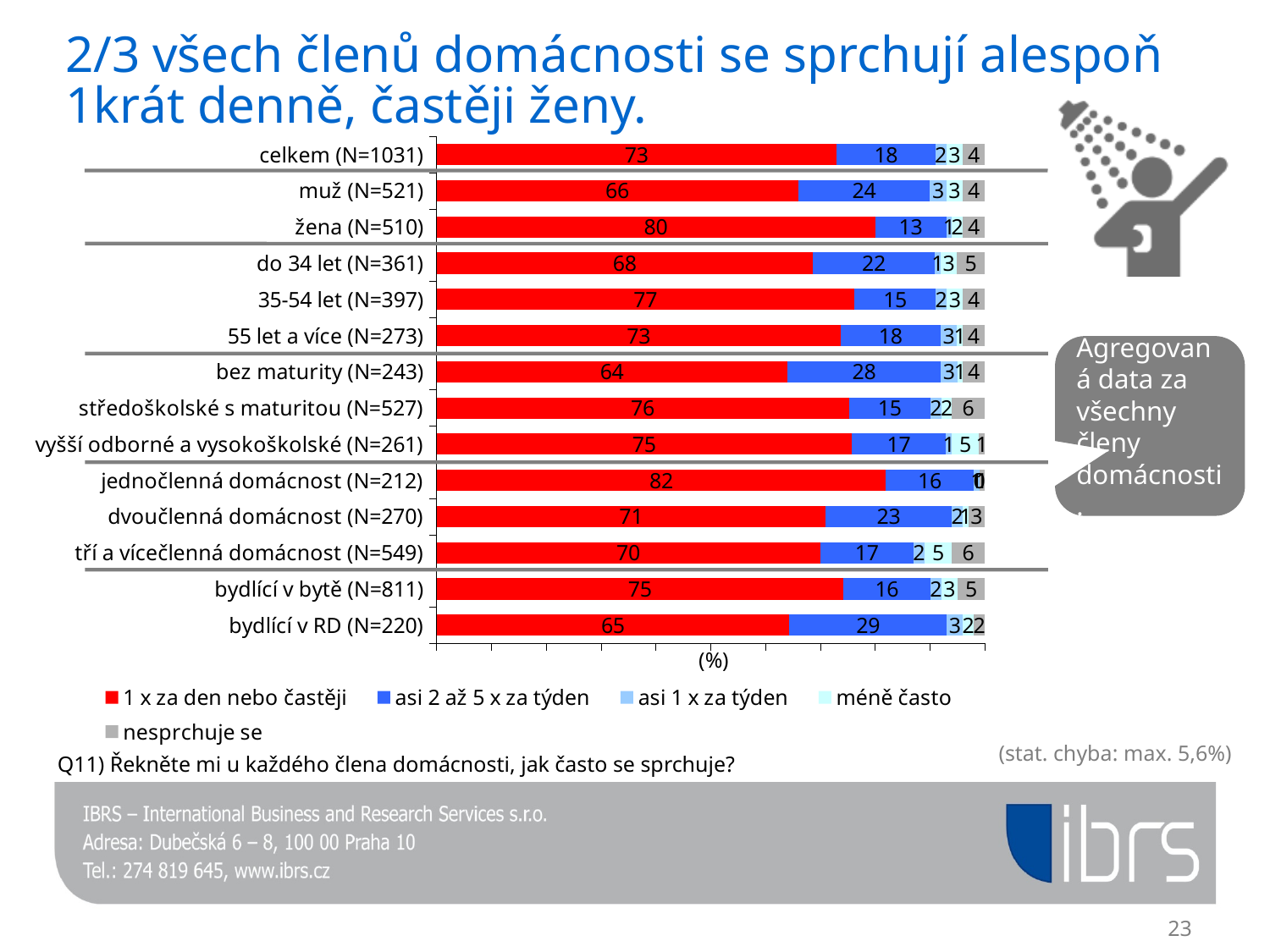
What is the value of 'asi 2 až 5 x za týden' for 'muž (N=521)'? 24 What is the difference between 'žena (N=510)' and 'muž (N=521)' in the '1 x za den nebo častěji' series? 14 Which series is shown in red in the legend? 1 x za den nebo častěji How many series does the legend list? 5 Which category has the lowest value for '1 x za den nebo častěji'? bez maturity (N=243) Which has a larger value for '1 x za den nebo častěji': 'bydlící v bytě (N=811)' or 'bydlící v RD (N=220)'? bydlící v bytě (N=811) Which category has the highest value for '1 x za den nebo častěji'? jednočlenná domácnost (N=212) What kind of chart is shown on the slide? stacked bar chart How many categories are shown on the chart? 14 What percentage of 'žena (N=510)' shower '1 x za den nebo častěji'? 80 Which category has the highest value for 'asi 2 až 5 x za týden'? bydlící v RD (N=220) What is the value of '1 x za den nebo častěji' for 'celkem (N=1031)'? 73